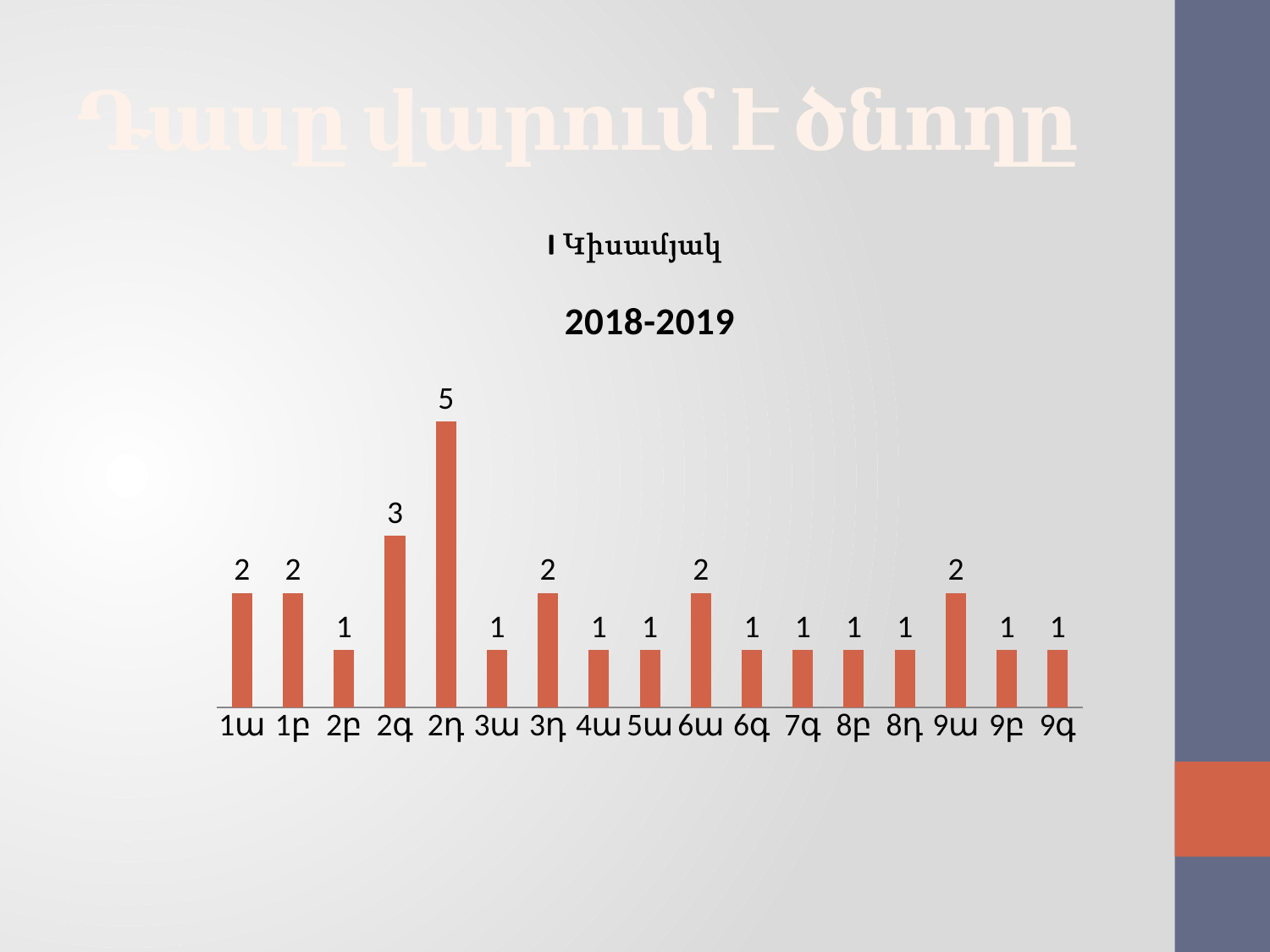
What is the difference between the values for 1ա and 2բ? 1 Which is larger, the value for 2գ or the value for 6ա? 2գ What is the value for 7գ? 1 Which category has the highest value? 2դ How many categories are shown on the x axis? 17 What is the value for 2դ? 5 What is the difference between the values for 2դ and 2գ? 2 Which is larger, the value for 3դ or the value for 3ա? 3դ What is the title of the chart? 2018-2019 What is the value for 2գ? 3 What is the value for 9ա? 2 What kind of chart is shown on the slide? bar chart